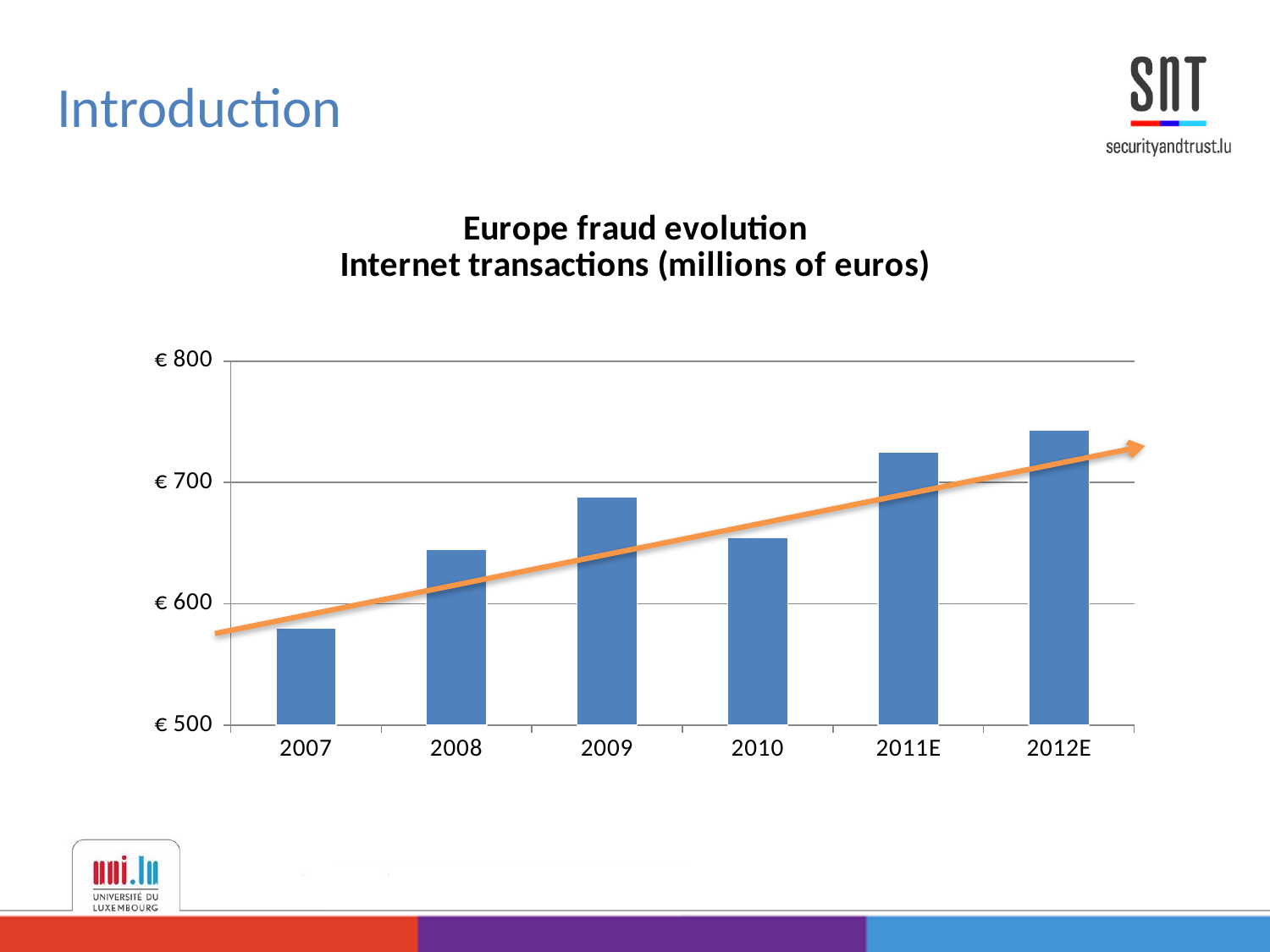
Which is larger, the value for 2009 or the value for 2010? 2009 Do the values generally rise or fall from 2007 to 2012E? rise Which year has the lowest value? 2007 How many categories (years) are shown on the x axis? 6 Which year has the highest value? 2012E What kind of chart is shown on the slide? bar chart Is the value for 2008 greater or less than € 600? greater Is the value for 2009 greater or less than € 700? less Is the value for 2011E greater or less than € 700? greater What is the title of the chart? Europe fraud evolution Internet transactions (millions of euros)